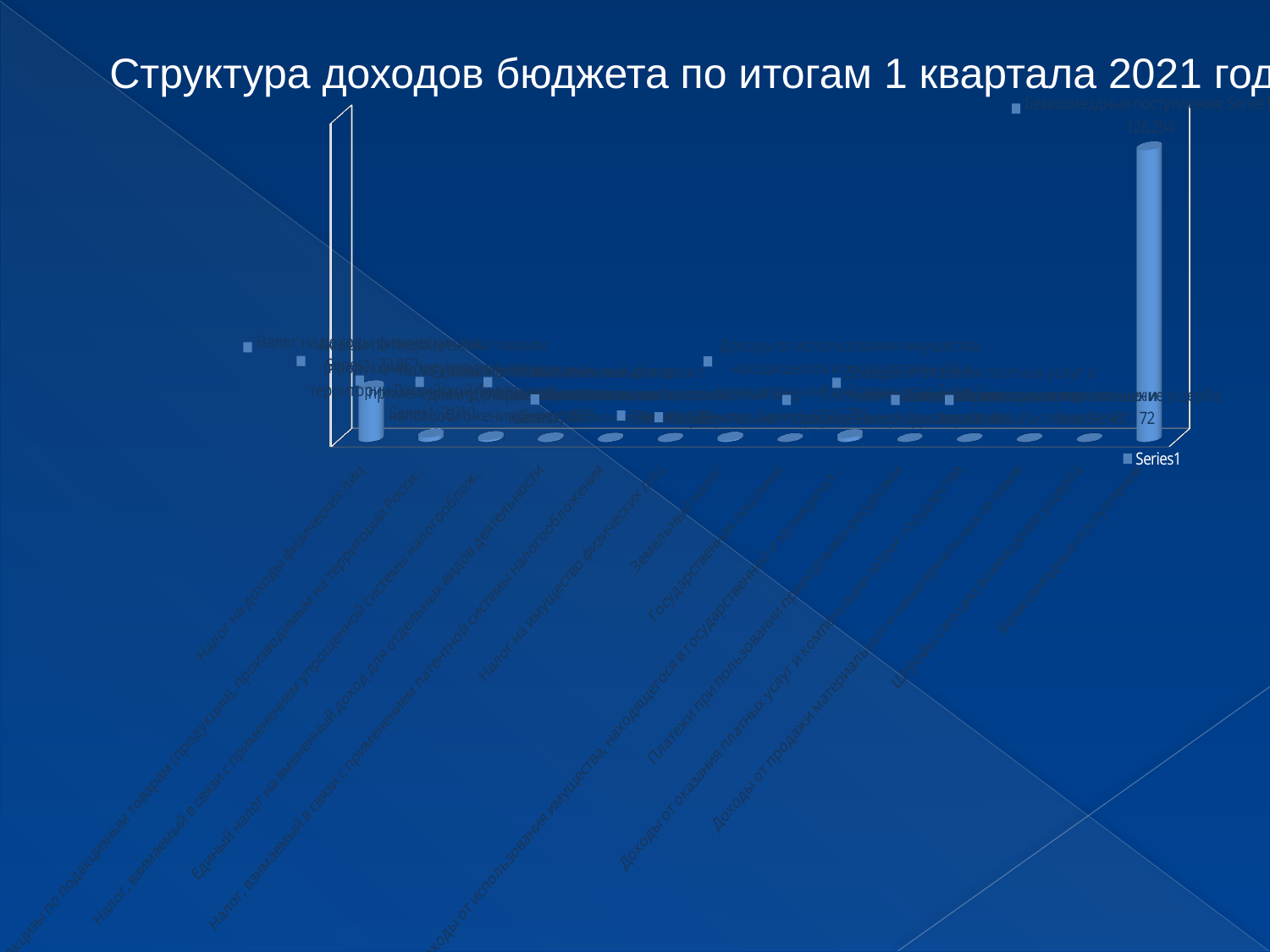
Which category has the highest value in the chart? Безвозмездные поступления How many categories are plotted along the x axis of the chart? 14 Which is larger: the value for Безвозмездные поступления or the value for Налог на доходы физических лиц? Безвозмездные поступления What is the value shown for Безвозмездные поступления? 126,294 What is the name of the series shown in the legend? Series1 What is the title of the slide? Структура доходов бюджета по итогам 1 квартала 2021 год What kind of chart is shown on the slide? Bar chart How many series does the legend list? 1